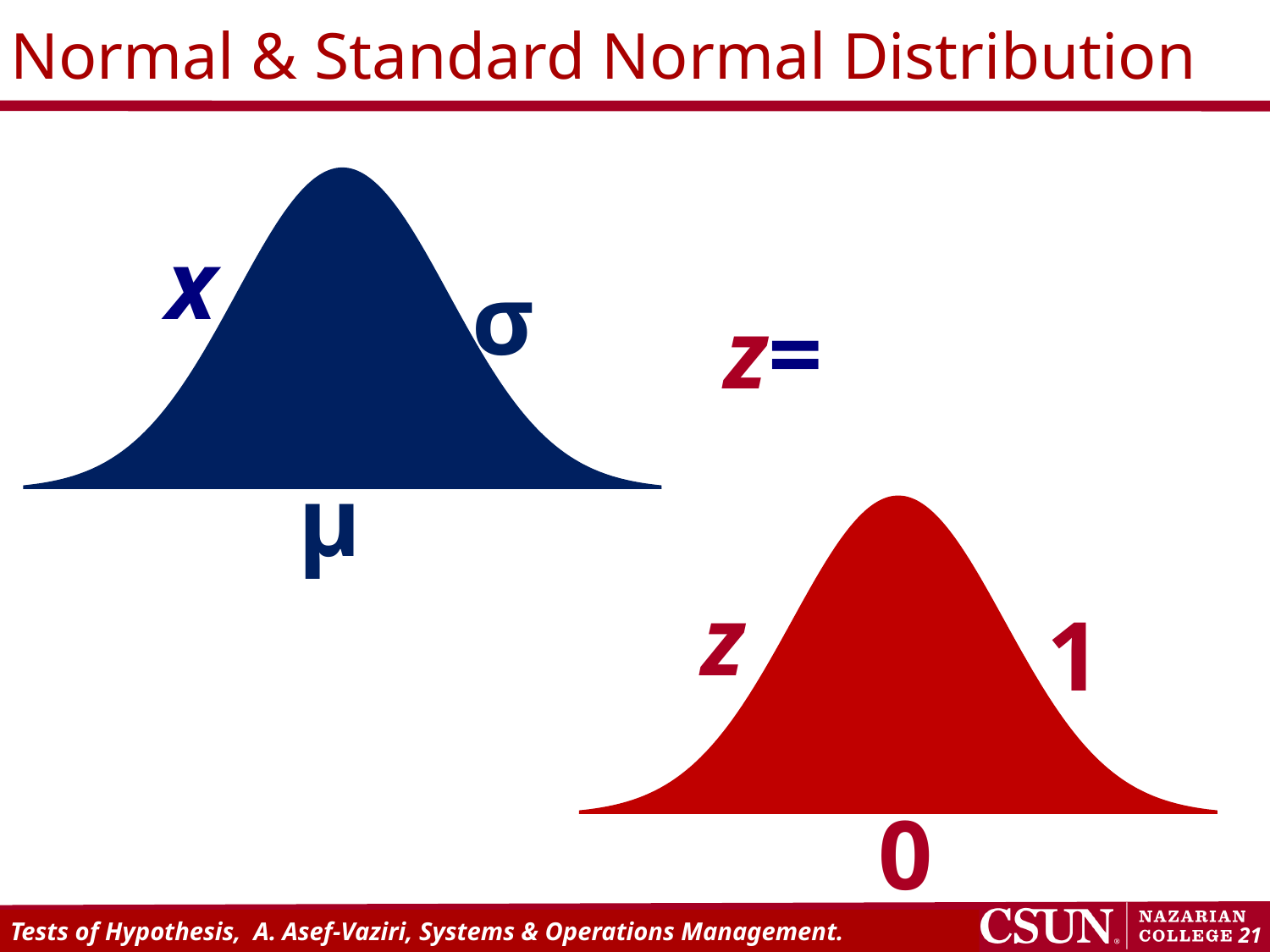
What is the title of the slide? Normal & Standard Normal Distribution What label appears beneath the peak of the red (lower-right) curve? 0 What variable letter is written on the left side of the red curve? z What number is written on the right side of the red curve? 1 What symbol is written on the right side of the blue curve, next to its slope? σ What variable letter is written on the left side of the blue curve? x What label appears beneath the peak of the blue (upper-left) curve? μ What colour is the curve representing the standard normal distribution (the one centred at 0)? Red How many bell-shaped distribution curves are drawn on the slide? 2